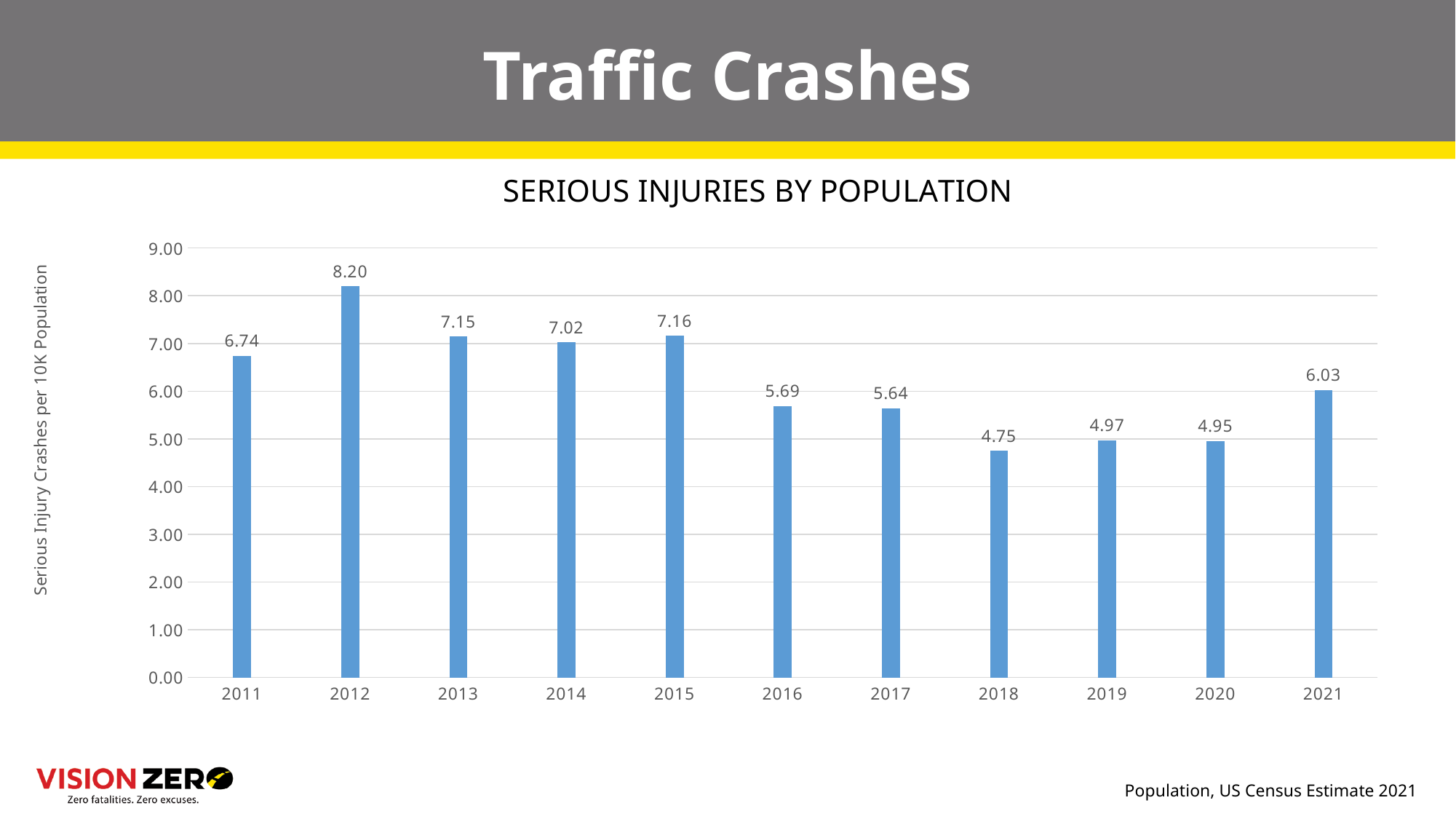
What is the value for 2018? 4.75 Which year has the highest value? 2012 What is the value for 2012? 8.20 Which is larger, the value for 2011 or the value for 2016? 2011 How many years are shown on the x axis? 11 What is the value for 2021? 6.03 What is the title of the chart? SERIOUS INJURIES BY POPULATION What is the difference between the values for 2012 and 2018? 3.45 Is the value for 2019 greater or less than 5.00? less Which year has the lowest value? 2018 Do the values generally rise or fall from 2012 to 2018? fall What kind of chart is this? bar chart